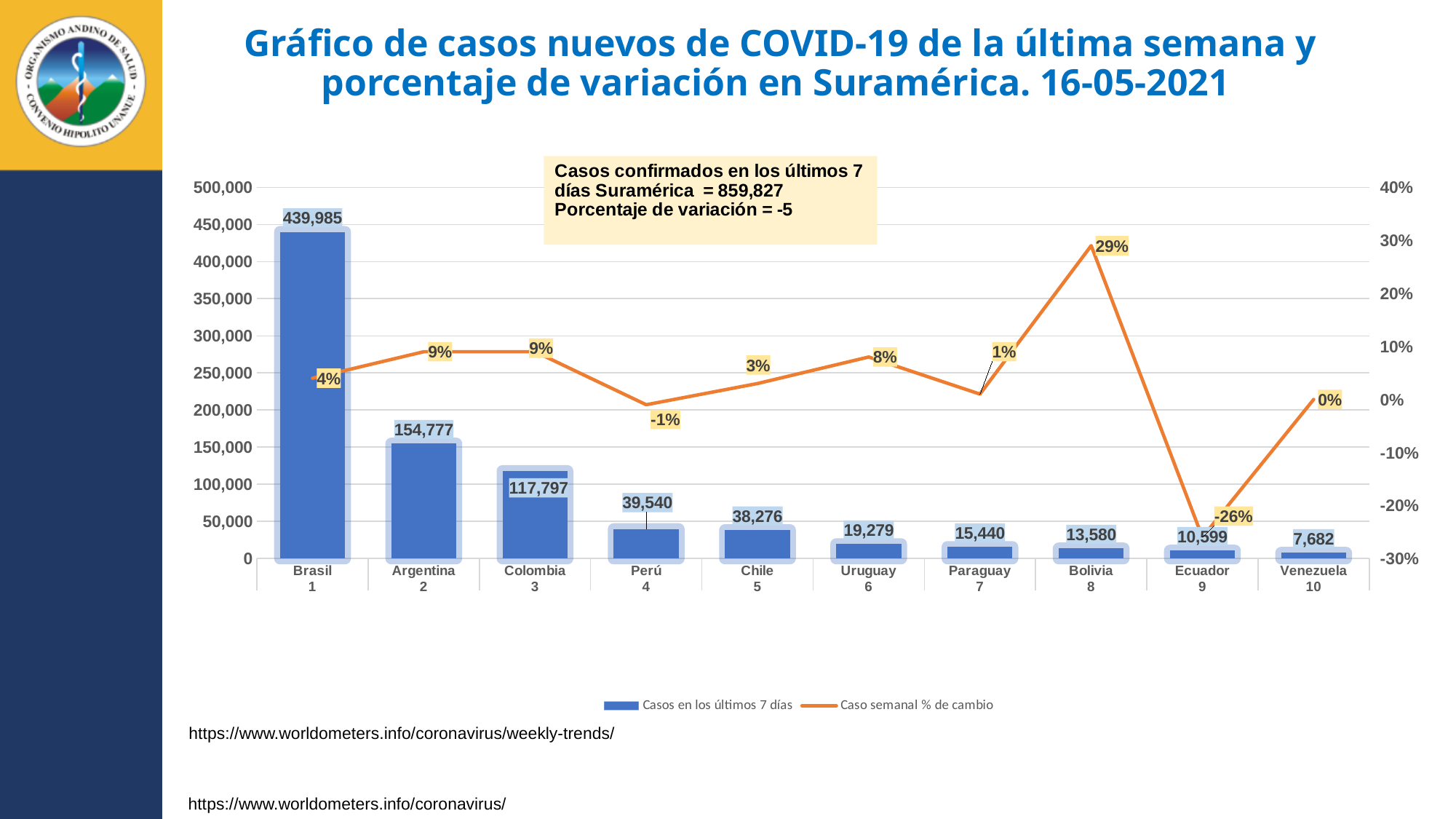
Which country has the lowest number of cases in the last 7 days? Venezuela How many countries are shown on the x axis? 10 What kind of chart is shown on the slide? Bar chart combined with a line chart What is the value of 'Casos en los últimos 7 días' for Brasil? 439,985 What is the difference in cases in the last 7 days between Argentina and Colombia? 36,980 Do the bar values for cases in the last 7 days rise or fall from left to right along the x axis? Fall Which has more cases in the last 7 days, Perú or Chile? Perú How many series does the legend list? 2 Which country has the lowest weekly percentage change? Ecuador Which country has the highest number of cases in the last 7 days? Brasil What is the value of 'Casos en los últimos 7 días' for Ecuador? 10,599 What is the 'Caso semanal % de cambio' value for Bolivia? 29%